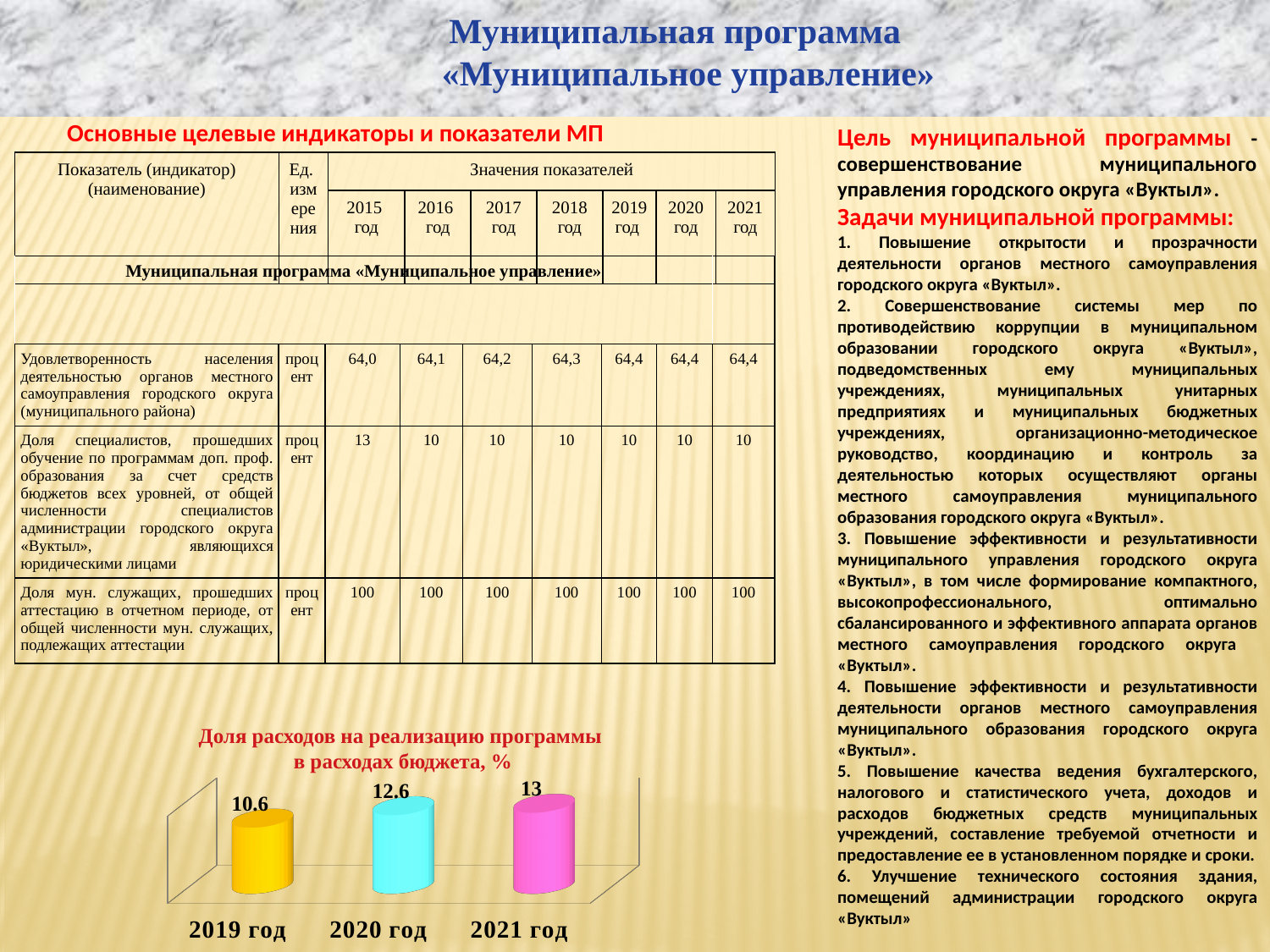
What colour is the bar for 2021 год in the chart 'Доля расходов на реализацию программы в расходах бюджета, %'? pink In the chart 'Доля расходов на реализацию программы в расходах бюджета, %', what is the difference between the values for 2021 год and 2019 год? 2.4 What is the value for 2021 год in the chart 'Доля расходов на реализацию программы в расходах бюджета, %'? 13 In the chart 'Доля расходов на реализацию программы в расходах бюджета, %', which is larger: the value for 2019 год or 2020 год? 2020 год Do the values in the chart 'Доля расходов на реализацию программы в расходах бюджета, %' rise or fall from 2019 год to 2021 год? rise In the chart 'Доля расходов на реализацию программы в расходах бюджета, %', what is the difference between the values for 2020 год and 2019 год? 2 How many years (categories) are shown in the chart 'Доля расходов на реализацию программы в расходах бюджета, %'? 3 Which year has the highest value in the chart 'Доля расходов на реализацию программы в расходах бюджета, %'? 2021 год What is the value for 2019 год in the chart 'Доля расходов на реализацию программы в расходах бюджета, %'? 10.6 What kind of chart is 'Доля расходов на реализацию программы в расходах бюджета, %'? bar chart Which year has the lowest value in the chart 'Доля расходов на реализацию программы в расходах бюджета, %'? 2019 год What is the value for 2020 год in the chart 'Доля расходов на реализацию программы в расходах бюджета, %'? 12.6